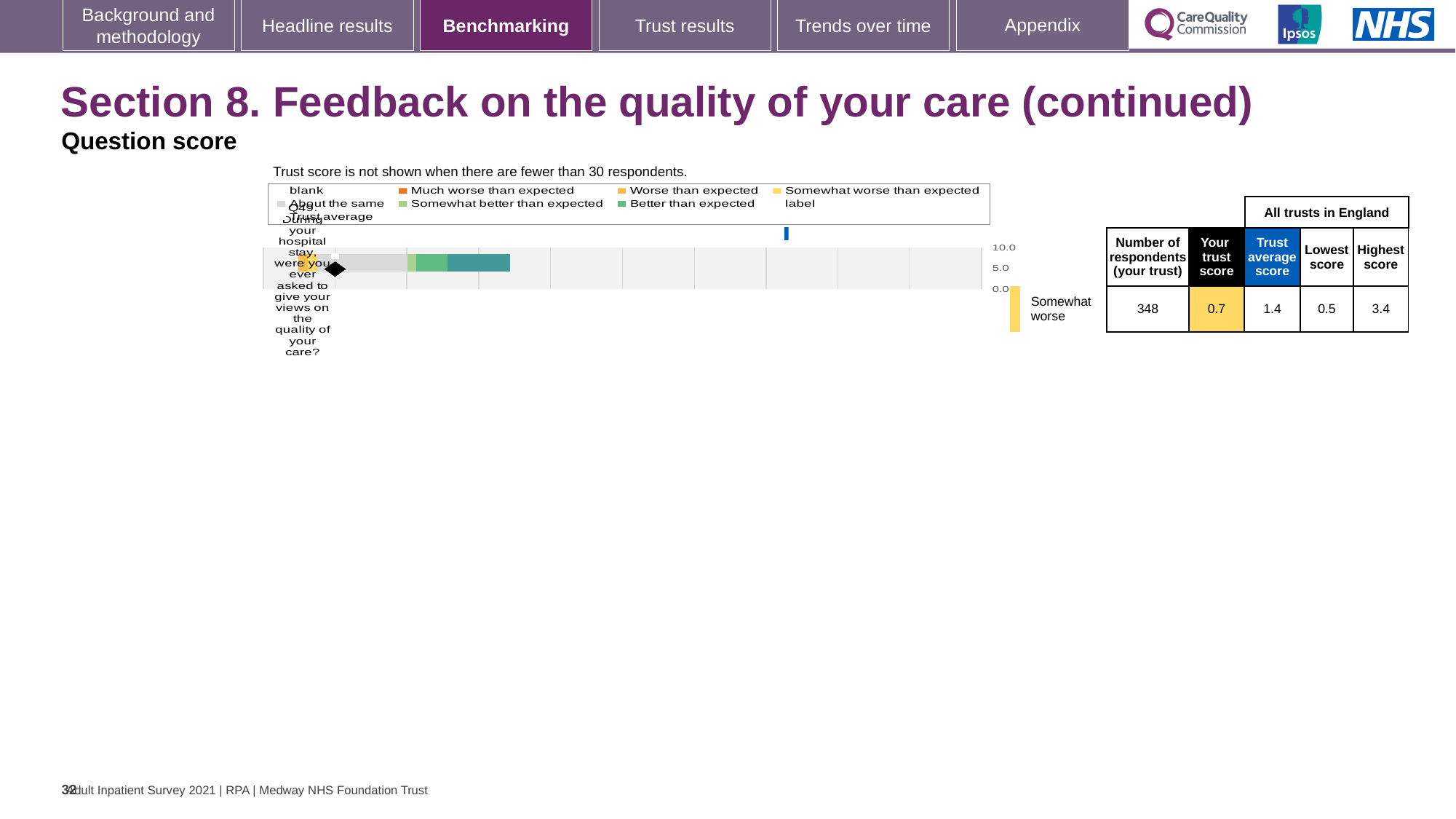
What is the difference between the trust average score and the trust's score for Q49? 0.7 How many questions (categories) are plotted on the chart? 1 What kind of chart is shown on the slide? bar chart What is the trust average score for Q49 across all trusts in England? 1.4 What is the trust's score for Q49 according to the table next to the chart? 0.7 What is the lowest score among all trusts in England for Q49? 0.5 What is the highest score among all trusts in England for Q49? 3.4 Which is larger for Q49: the trust's score or the trust average score? trust average score What is the highest value shown on the chart's axis? 10.0 Is the trust score marker for Q49 greater or less than 5.0 on the axis? less Which question is plotted on the chart? Q49. During your hospital stay, were you ever asked to give your views on the quality of your care? How many respondents from the trust answered Q49? 348